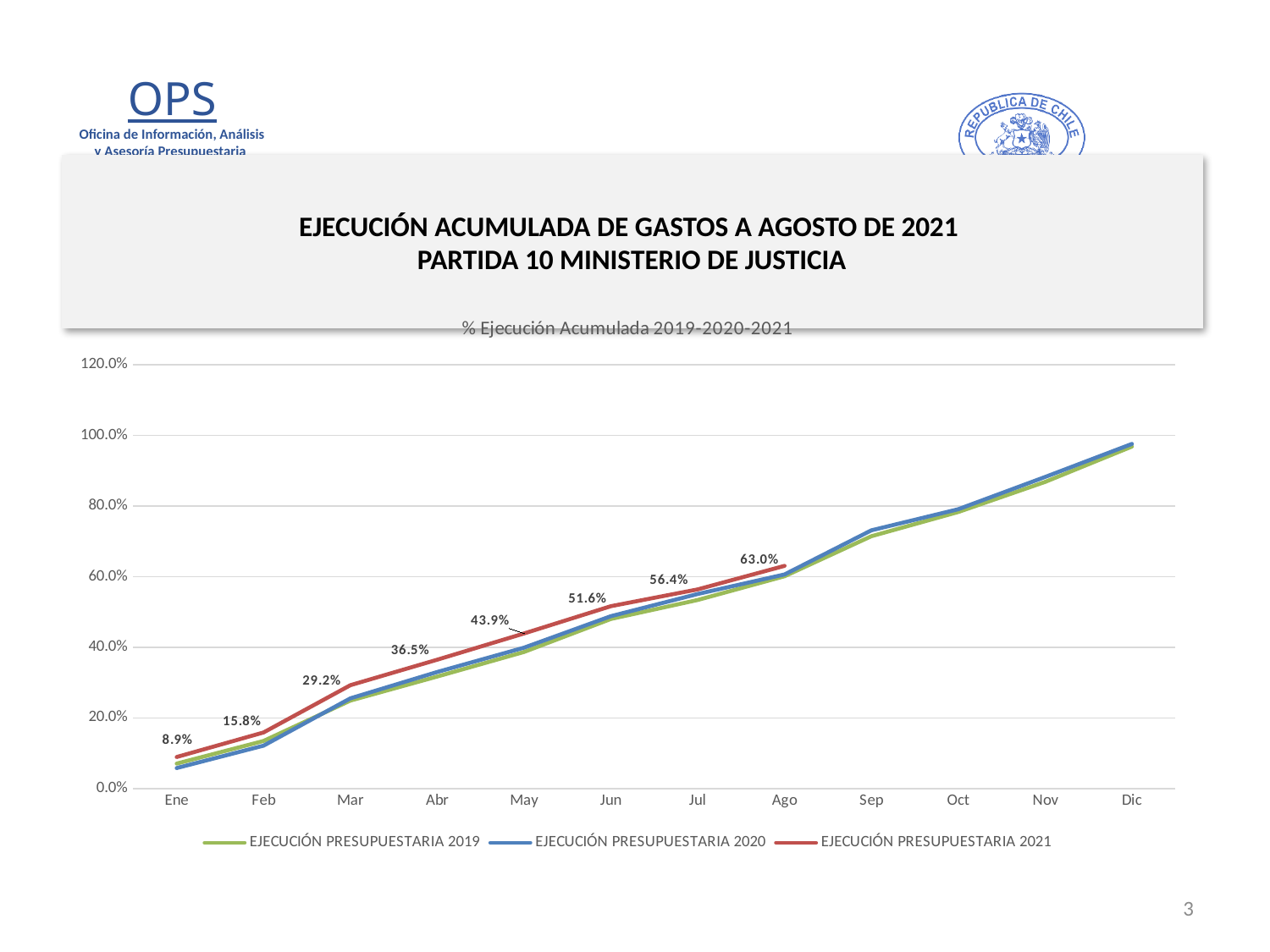
Is the value for Dic in the EJECUCIÓN PRESUPUESTARIA 2020 series greater or less than 80.0%? greater Which month has the highest labelled value in the EJECUCIÓN PRESUPUESTARIA 2021 series? Ago What is the difference between the Ago and Jul values in the EJECUCIÓN PRESUPUESTARIA 2021 series? 6.6% What is the value for Ene in the EJECUCIÓN PRESUPUESTARIA 2021 series? 8.9% What is the value for May in the EJECUCIÓN PRESUPUESTARIA 2021 series? 43.9% How many series does the legend list? 3 What kind of chart is shown on the slide? Line chart What is the value for Mar in the EJECUCIÓN PRESUPUESTARIA 2021 series? 29.2% What is the difference between the Mar and Feb values in the EJECUCIÓN PRESUPUESTARIA 2021 series? 13.4% Do the values in the EJECUCIÓN PRESUPUESTARIA 2021 series rise or fall from Ene to Ago? Rise Is the value for Ene in the EJECUCIÓN PRESUPUESTARIA 2020 series greater or less than 20.0%? less What is the value for Ago in the EJECUCIÓN PRESUPUESTARIA 2021 series? 63.0%